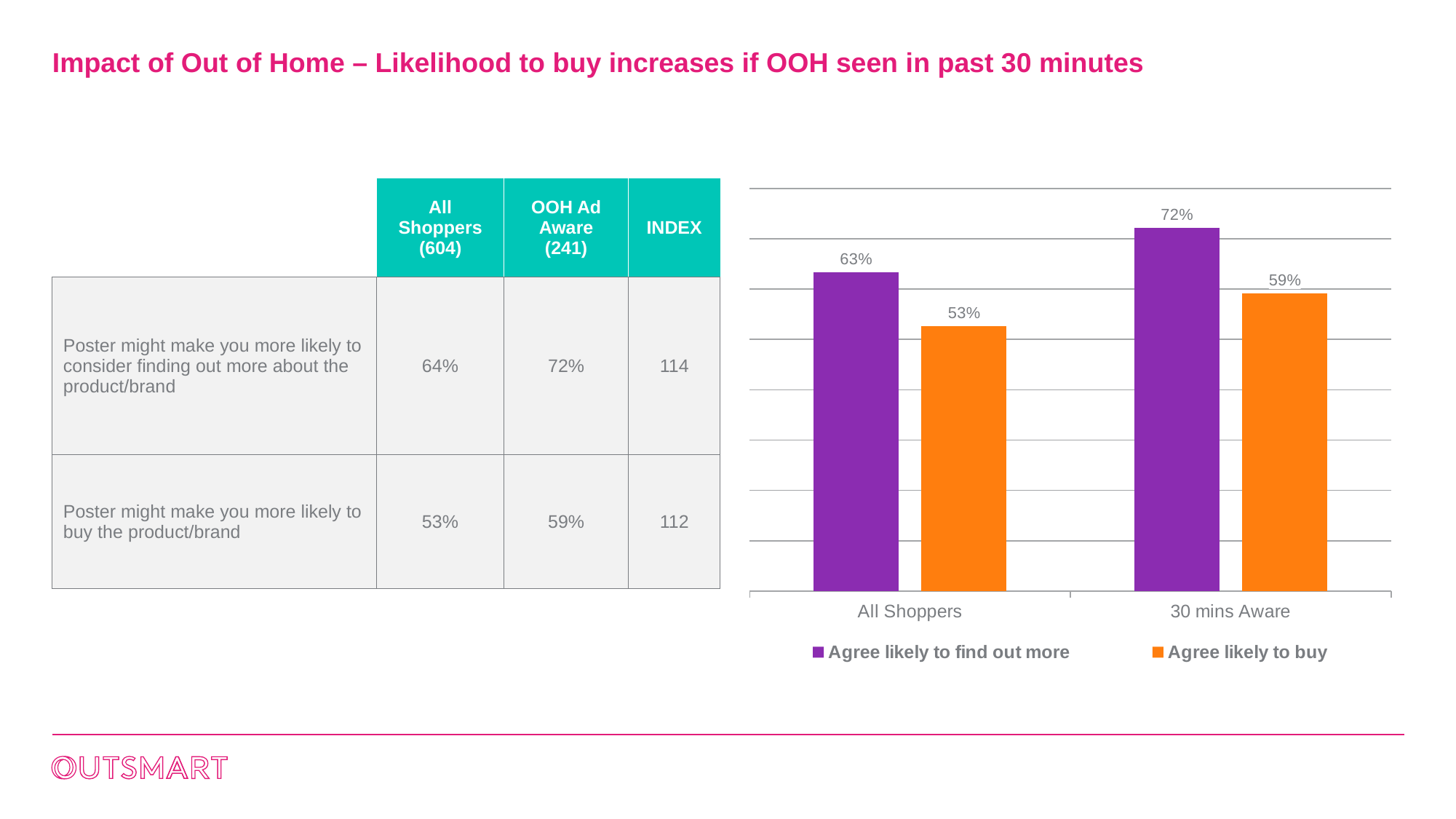
In the chart, what is the value for 'Agree likely to find out more' in the 30 mins Aware group? 72% In the chart, what is the value for 'Agree likely to buy' in the 30 mins Aware group? 59% Which bar in the chart has the lowest value? Agree likely to buy, All Shoppers (53%) Which is larger: 'Agree likely to find out more' for All Shoppers or 'Agree likely to buy' for 30 mins Aware? Agree likely to find out more for All Shoppers (63%) In the chart, what is the value for 'Agree likely to find out more' among All Shoppers? 63% What is the difference between 'Agree likely to buy' for 30 mins Aware and for All Shoppers? 6 percentage points What type of chart is shown on the slide? Bar chart How many categories are shown on the x axis of the chart? 2 How many series does the chart legend list? 2 Which bar in the chart has the highest value? Agree likely to find out more, 30 mins Aware (72%) What is the difference between 'Agree likely to find out more' for 30 mins Aware and for All Shoppers? 9 percentage points In the chart, what is the value for 'Agree likely to buy' among All Shoppers? 53%